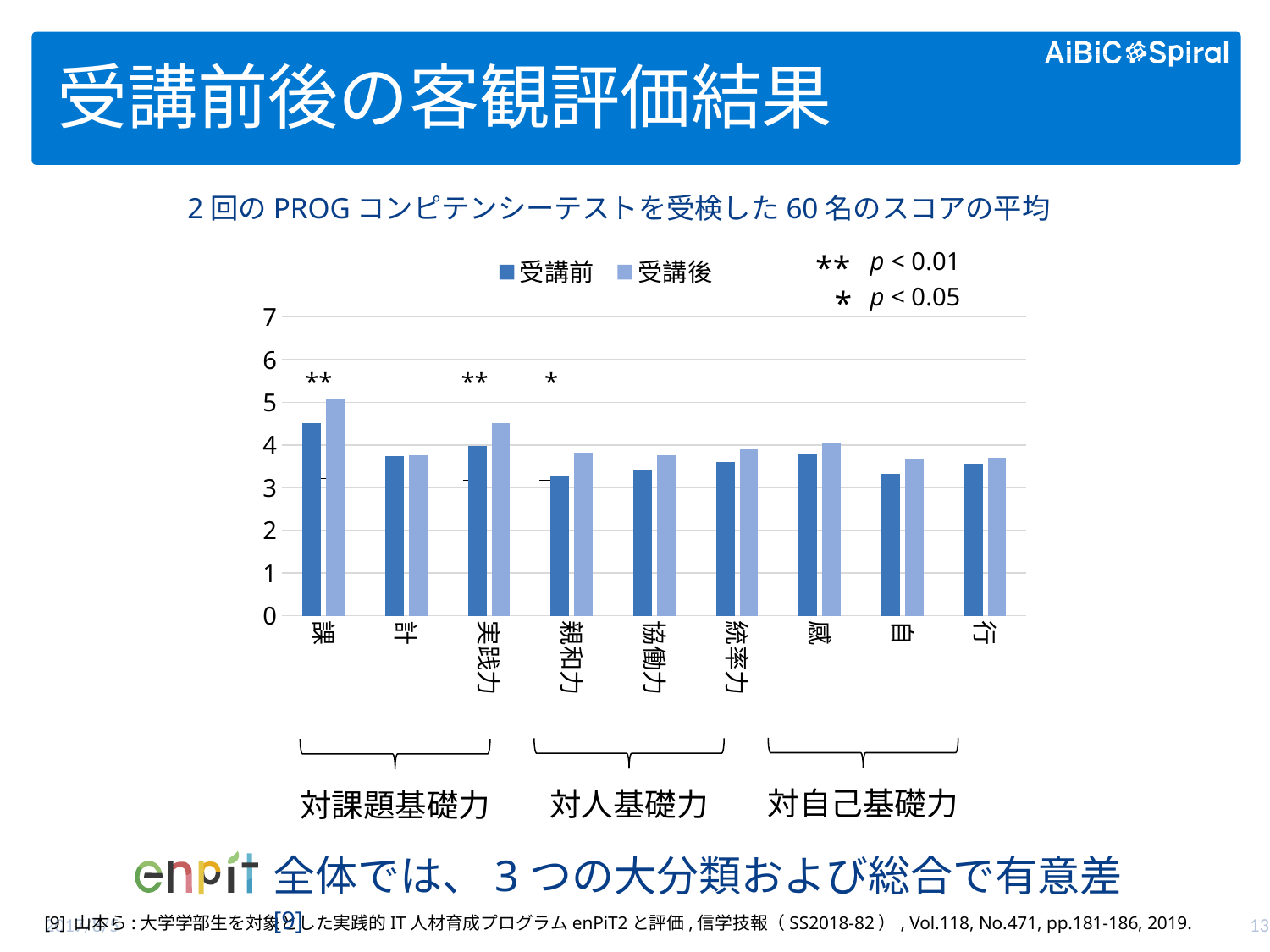
Which has the larger 受講前 value: 実践力 or 協働力? 実践力 Is the 受講前 value for 親和力 greater or less than 4? less How many series does the chart legend list? 2 Is the 受講前 value for 実践力 greater or less than 3? greater For 実践力, which is larger: the 受講前 value or the 受講後 value? 受講後 How many categories are plotted along the x axis of the chart? 9 Is the 受講後 value for 実践力 greater or less than 4? greater How many categories in the chart are marked with ** (p < 0.01)? 2 What kind of chart is shown on the slide? bar chart For 親和力, which is larger: the 受講前 value or the 受講後 value? 受講後 What are the two series named in the chart legend? 受講前 and 受講後